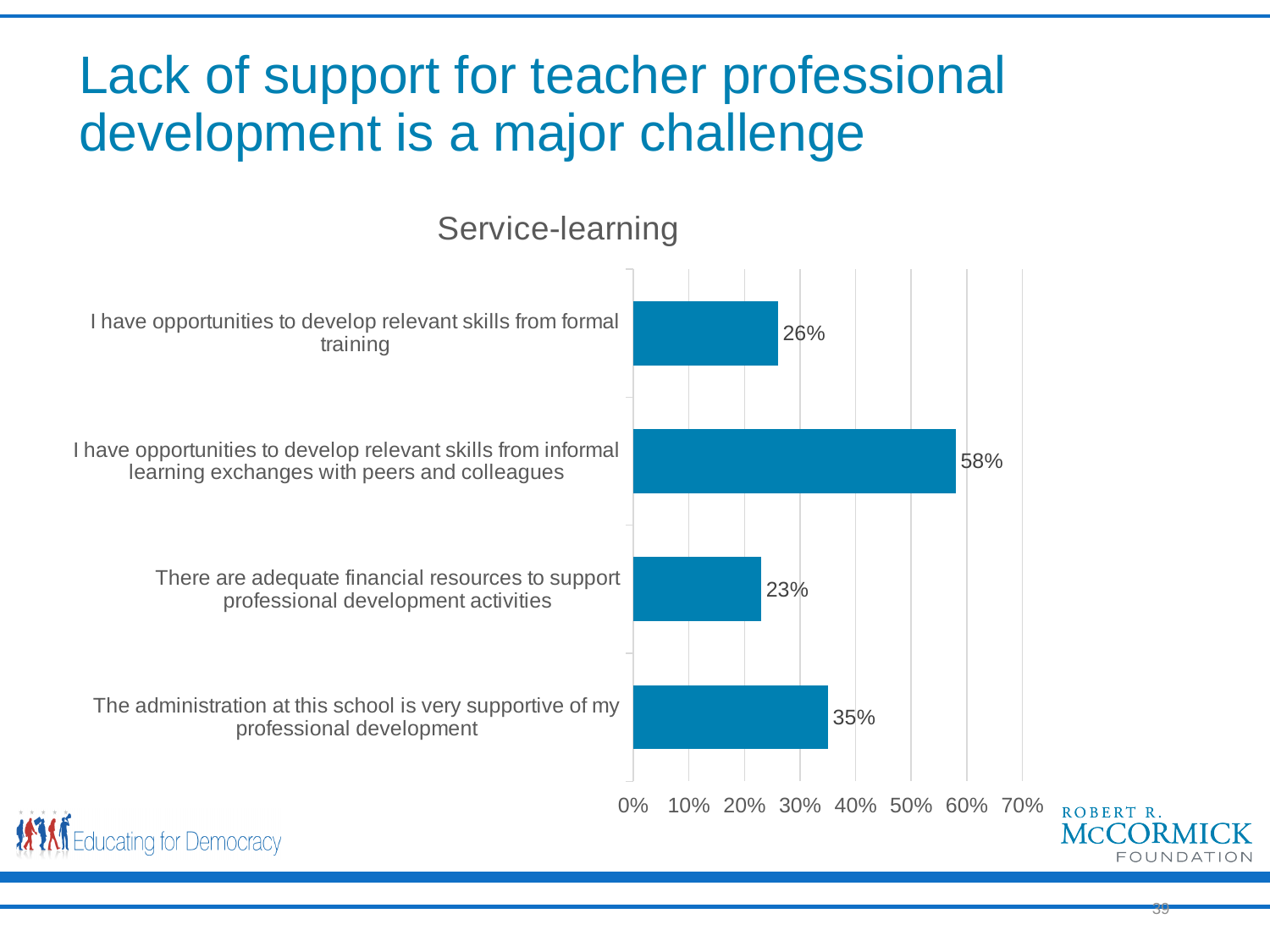
What type of chart is shown on the slide? Bar chart What percentage agreed that there are adequate financial resources to support professional development activities? 23% What is the title of the chart? Service-learning Which statement has the lowest percentage? There are adequate financial resources to support professional development activities What percentage of respondents said they have opportunities to develop relevant skills from formal training? 26% What is the value for 'I have opportunities to develop relevant skills from informal learning exchanges with peers and colleagues'? 58% How many statements are shown in the chart? 4 What is the value for 'The administration at this school is very supportive of my professional development'? 35% What is the difference between the value for informal learning exchanges and the value for formal training? 32% Which statement has the highest percentage? I have opportunities to develop relevant skills from informal learning exchanges with peers and colleagues Is the value for informal learning exchanges with peers and colleagues greater or less than 50%? greater Which is larger: the value for administration being very supportive or the value for adequate financial resources? The administration at this school is very supportive of my professional development